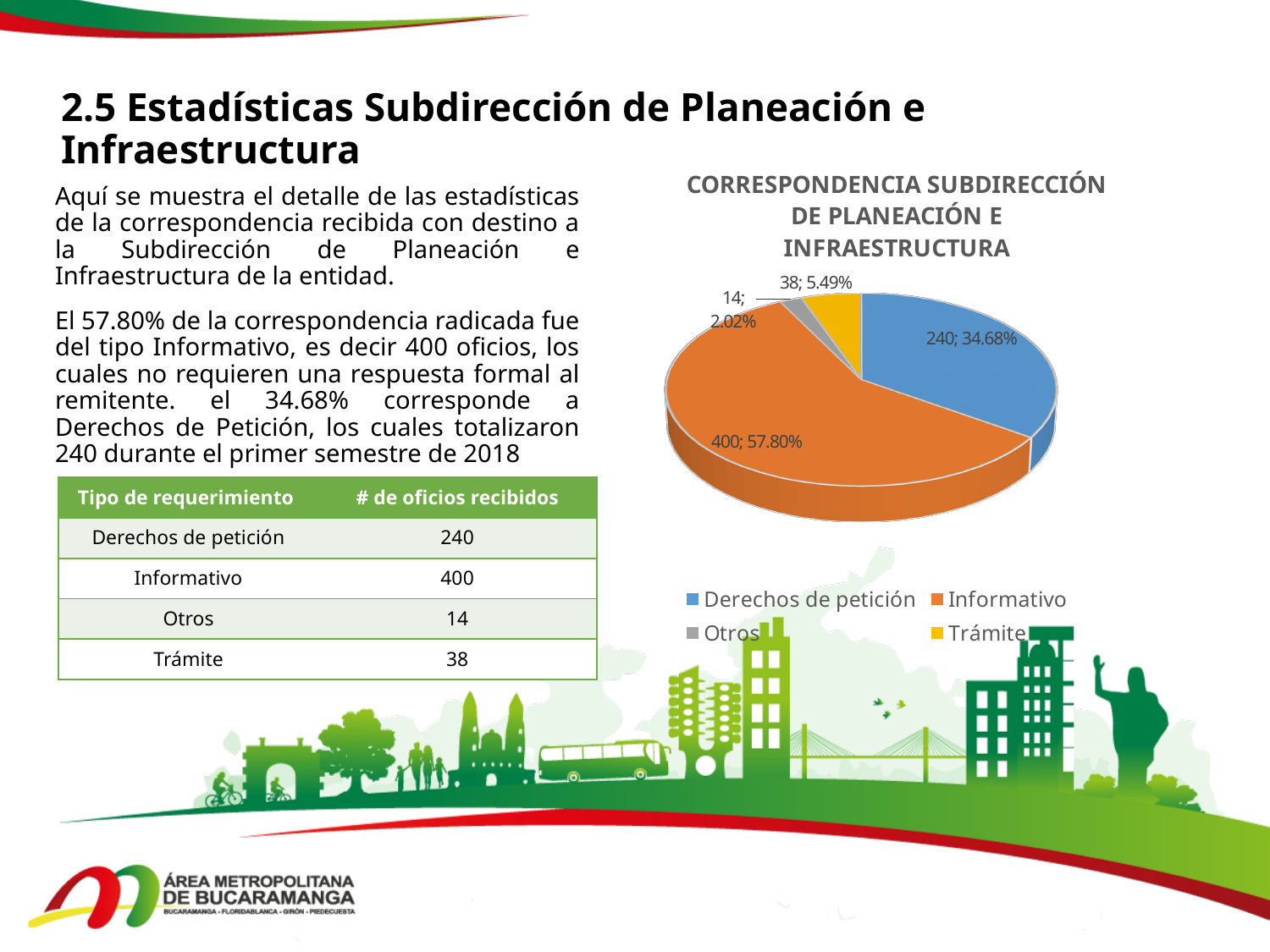
How many slices does the pie chart have? 4 How many entries does the chart legend list? 4 What is the difference between the Informativo value and the Derechos de petición value? 160 What value is shown for the Informativo slice? 400 Which category has the largest slice in the pie chart? Informativo Which is larger, the Trámite slice or the Otros slice? Trámite What is the title of the chart? CORRESPONDENCIA SUBDIRECCIÓN DE PLANEACIÓN E INFRAESTRUCTURA What percentage share does the Otros slice have? 2.02% What kind of chart is shown on the slide? Pie chart What value is shown for the Trámite slice? 38 What percentage share does the Derechos de petición slice have? 34.68% Which category has the smallest slice in the pie chart? Otros